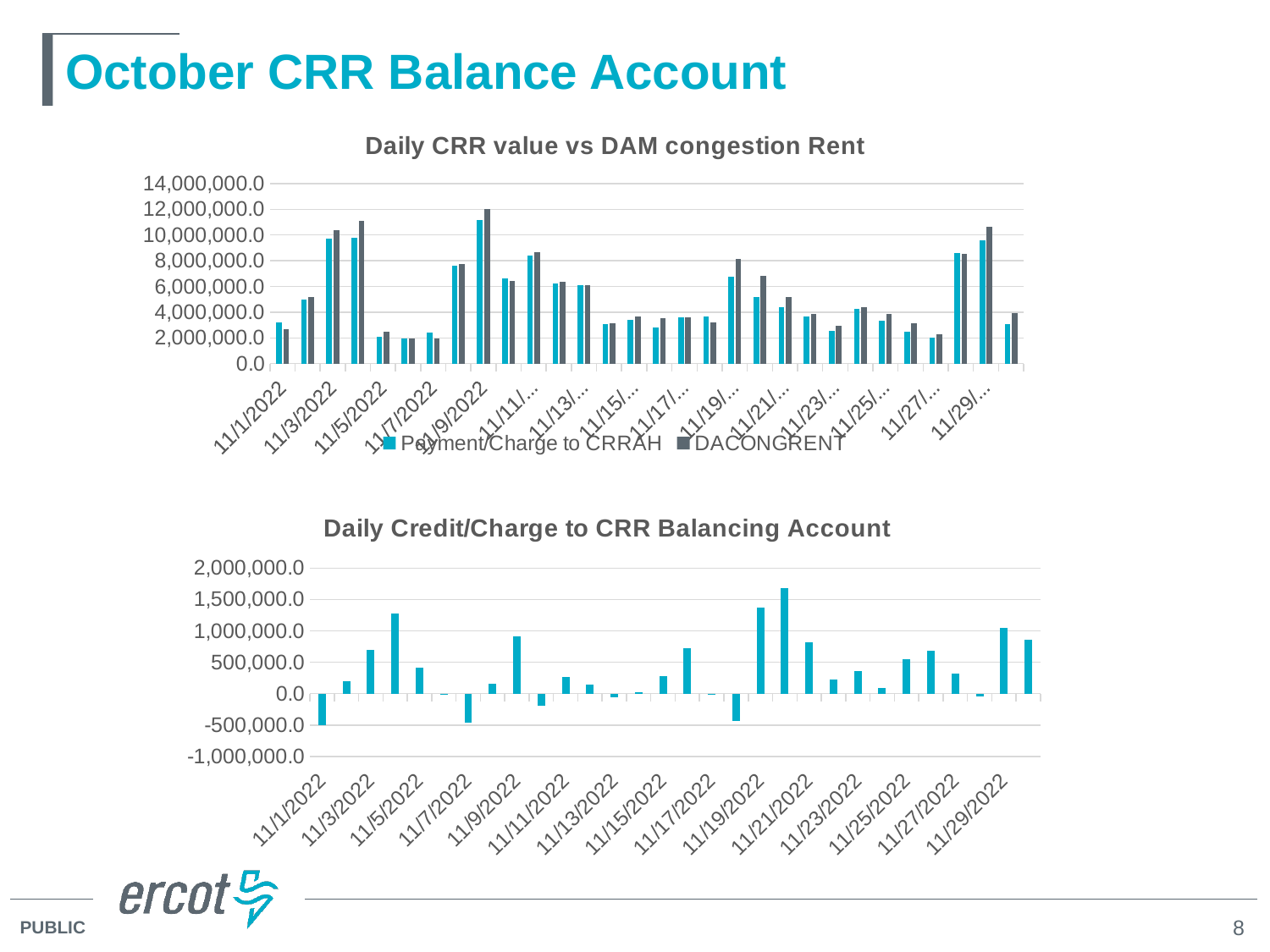
In the bottom chart 'Daily Credit/Charge to CRR Balancing Account', is the value for 11/5/2022 greater or less than 1,000,000.0? less In the top chart 'Daily CRR value vs DAM congestion Rent', which date has the larger Payment/Charge to CRRAH value: 11/1/2022 or 11/9/2022? 11/9/2022 In the bottom chart 'Daily Credit/Charge to CRR Balancing Account', is the value for 11/7/2022 greater or less than 0.0? less In the top chart 'Daily CRR value vs DAM congestion Rent', is the Payment/Charge to CRRAH value for 11/9/2022 greater or less than 10,000,000.0? greater How many series does the legend of the top chart 'Daily CRR value vs DAM congestion Rent' list? 2 In the top chart 'Daily CRR value vs DAM congestion Rent', what are the two series named in the legend? Payment/Charge to CRRAH and DACONGRENT In the top chart 'Daily CRR value vs DAM congestion Rent', which is larger for 11/9/2022: Payment/Charge to CRRAH or DACONGRENT? DACONGRENT What kind of chart is the top chart titled 'Daily CRR value vs DAM congestion Rent'? bar chart What is the title of the bottom chart on the slide? Daily Credit/Charge to CRR Balancing Account What kind of chart is the bottom chart titled 'Daily Credit/Charge to CRR Balancing Account'? bar chart